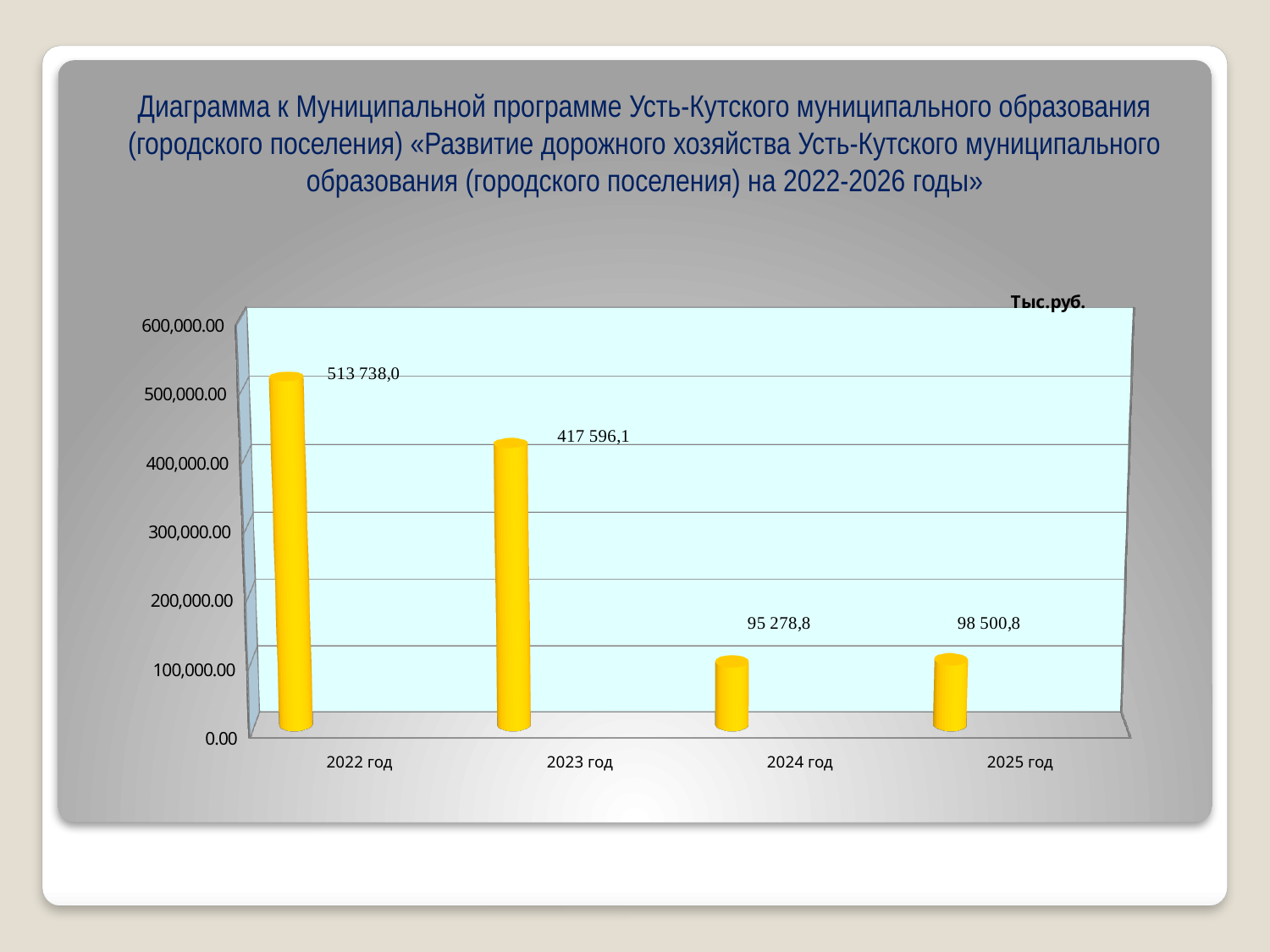
What is the value for 2023 год? 417 596,1 How many years are shown on the x axis? 4 Which year has the highest value? 2022 год Is the value for 2023 год greater or less than 400,000.00? greater What is the difference between the values for 2022 год and 2023 год? 96 141,9 Which is larger, the value for 2024 год or 2025 год? 2025 год What unit is indicated at the top right of the chart? Тыс.руб. Which year has the lowest value? 2024 год What is the value for 2025 год? 98 500,8 What kind of chart is shown on the slide? bar chart What is the value for 2024 год? 95 278,8 What is the value for 2022 год? 513 738,0